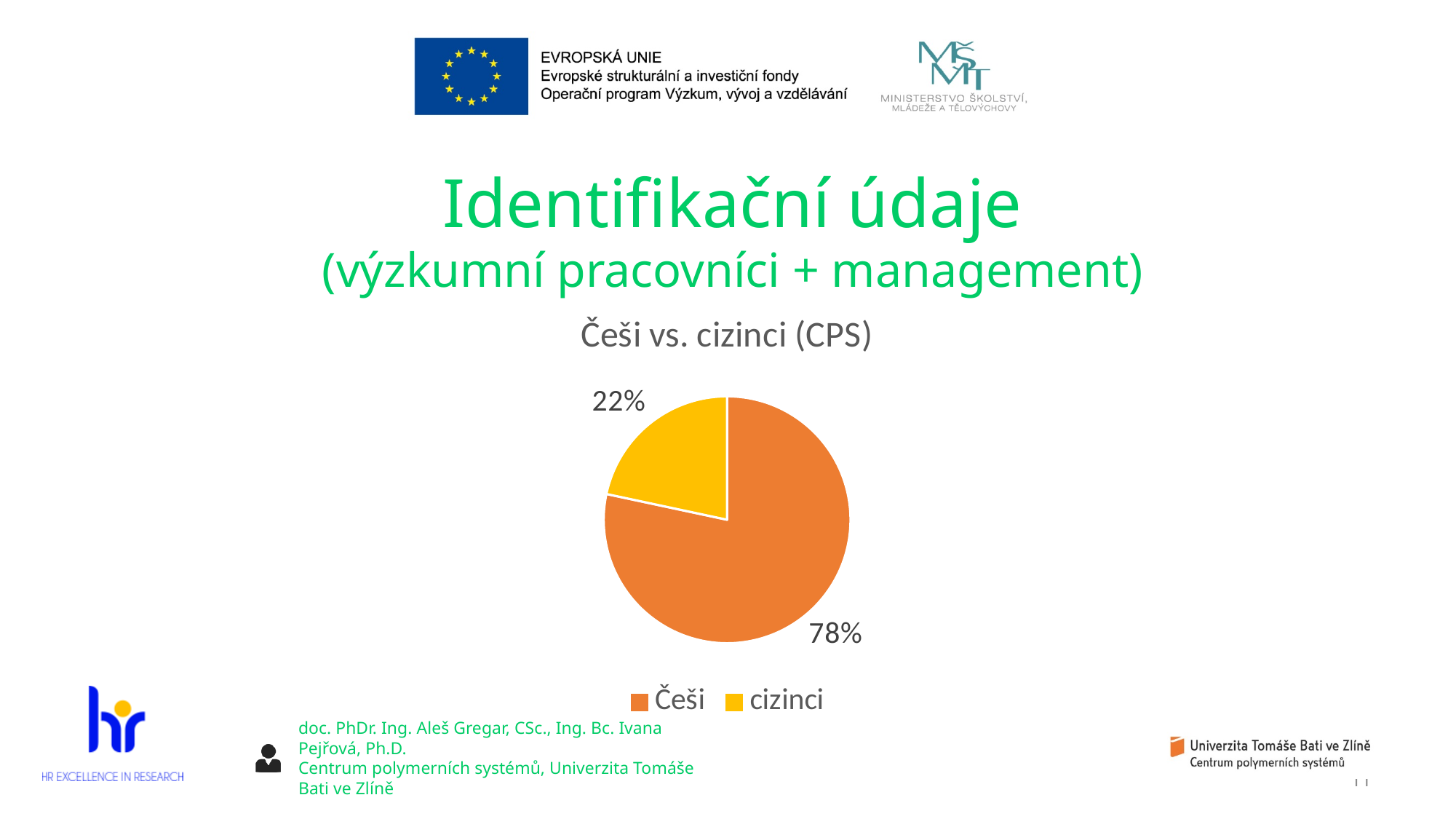
What colour is the cizinci slice? yellow Which category has the largest slice of the pie? Češi How many slices does the pie chart have? 2 What is the title of the chart? Češi vs. cizinci (CPS) What is the difference in percentage points between the Češi slice and the cizinci slice? 56 Which category has the smallest slice of the pie? cizinci What share of the pie is labelled for Češi? 78% How many entries does the legend list? 2 What share of the pie is labelled for cizinci? 22% Is the share for Češi greater or less than 50%? greater Which slice is larger, Češi or cizinci? Češi What kind of chart is shown on the slide? pie chart